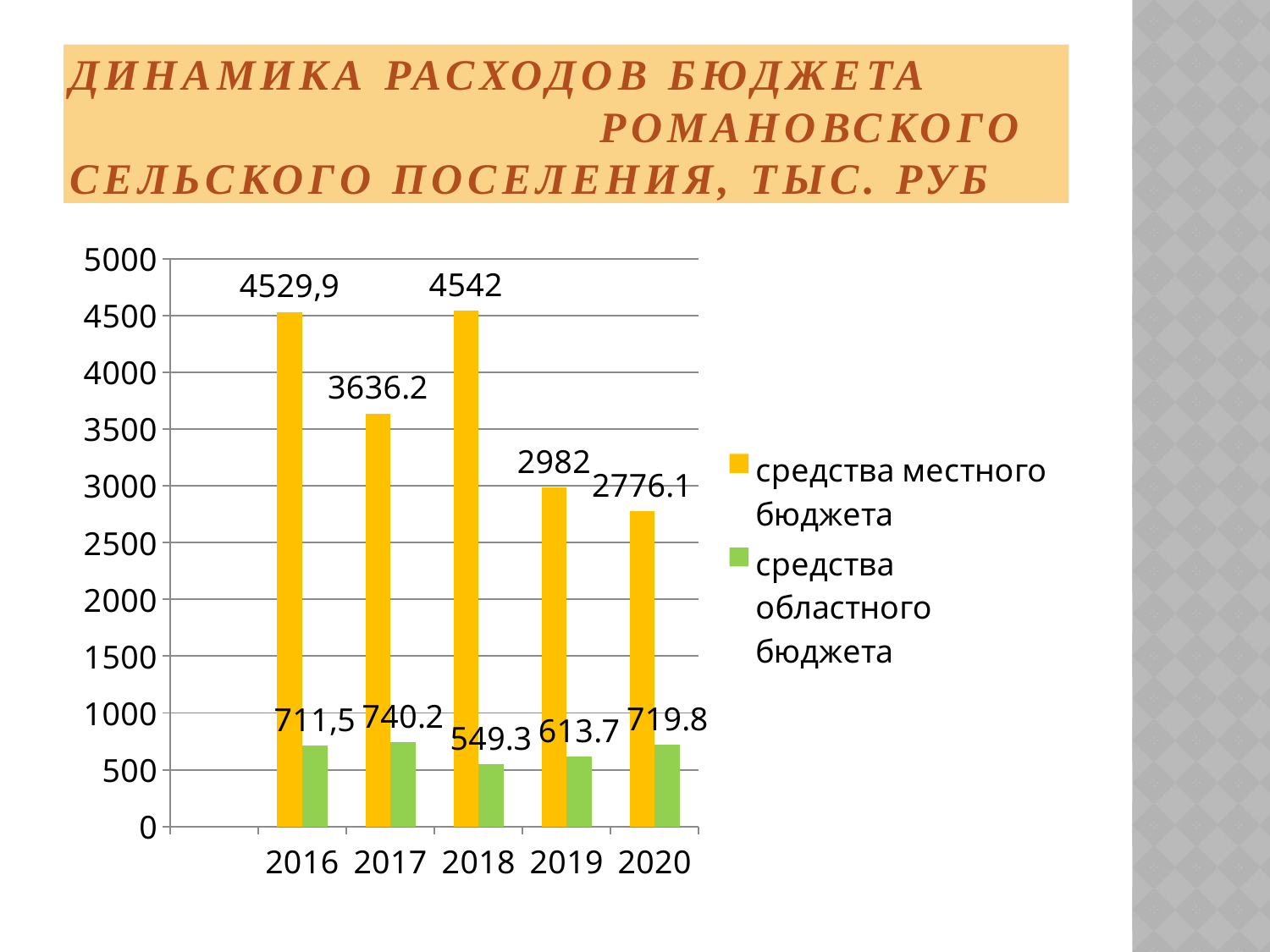
How many series does the legend list? 2 What is the value for средства областного бюджета in 2018? 549.3 How many years are shown on the x axis? 5 What kind of chart is shown on the slide? bar chart What is the value for средства местного бюджета in 2020? 2776.1 What is the value for средства местного бюджета in 2016? 4529,9 Is the value for средства местного бюджета in 2020 greater or less than 3000? less Which is larger: средства местного бюджета in 2017 or in 2019? 2017 In which year is средства местного бюджета the lowest? 2020 What is the difference between средства местного бюджета in 2018 and in 2019? 1560 In which year is средства областного бюджета the highest? 2017 In which year is средства областного бюджета the lowest? 2018